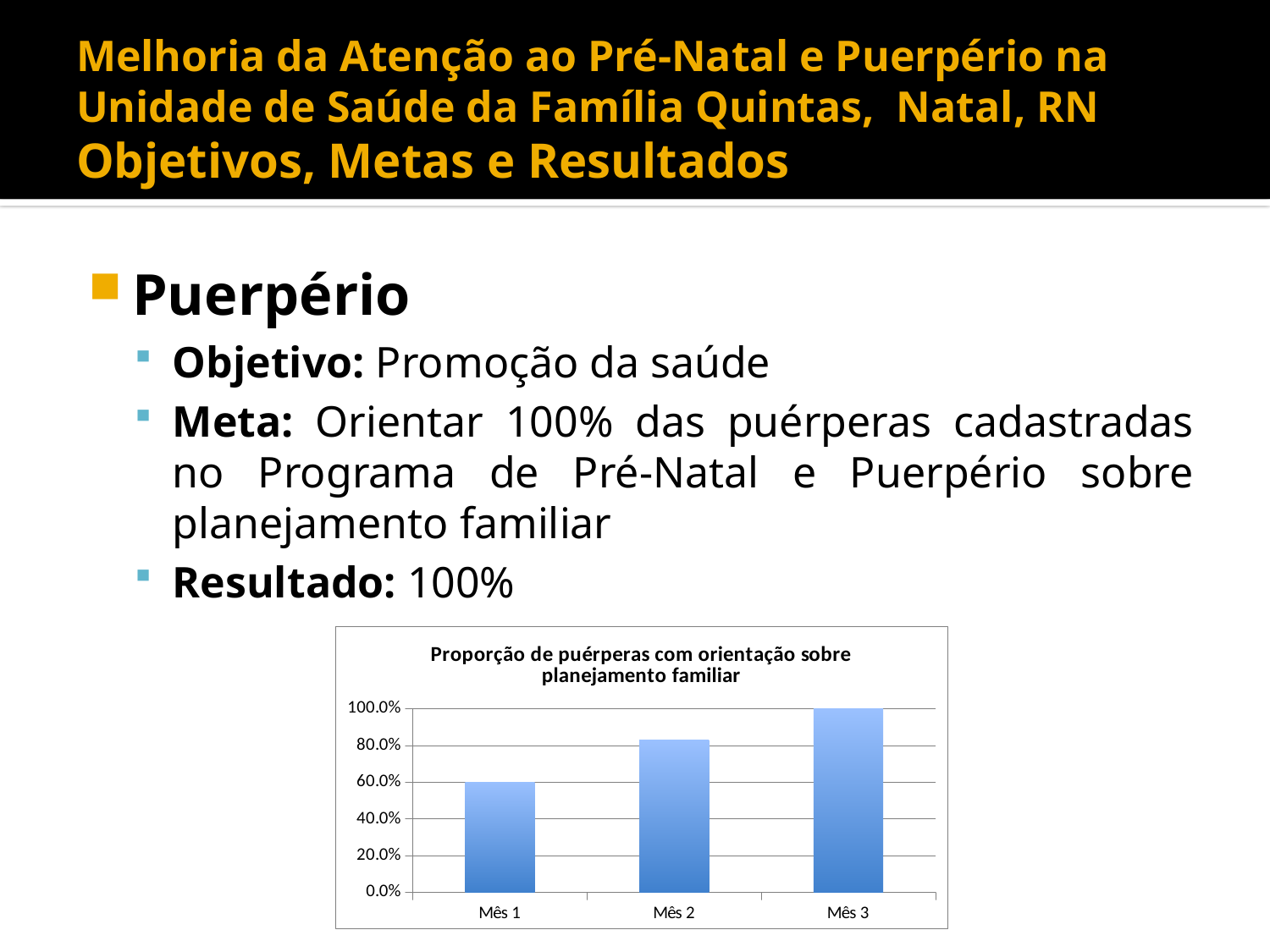
How many categories are shown on the x axis of the chart? 3 Do the values rise or fall from Mês 1 to Mês 3? rise What is the value for Mês 3 in the chart? 100.0% Is the value for Mês 2 greater or less than 100.0%? less What is the value for Mês 1 in the chart? 60.0% Which month has the highest value in the chart? Mês 3 What is the title of the chart? Proporção de puérperas com orientação sobre planejamento familiar What kind of chart is shown on the slide? bar chart Is the value for Mês 2 greater or less than 80.0%? greater What is the difference between the values for Mês 3 and Mês 1? 40.0% Which month has the lowest value in the chart? Mês 1 Which is larger, the value for Mês 1 or the value for Mês 2? Mês 2